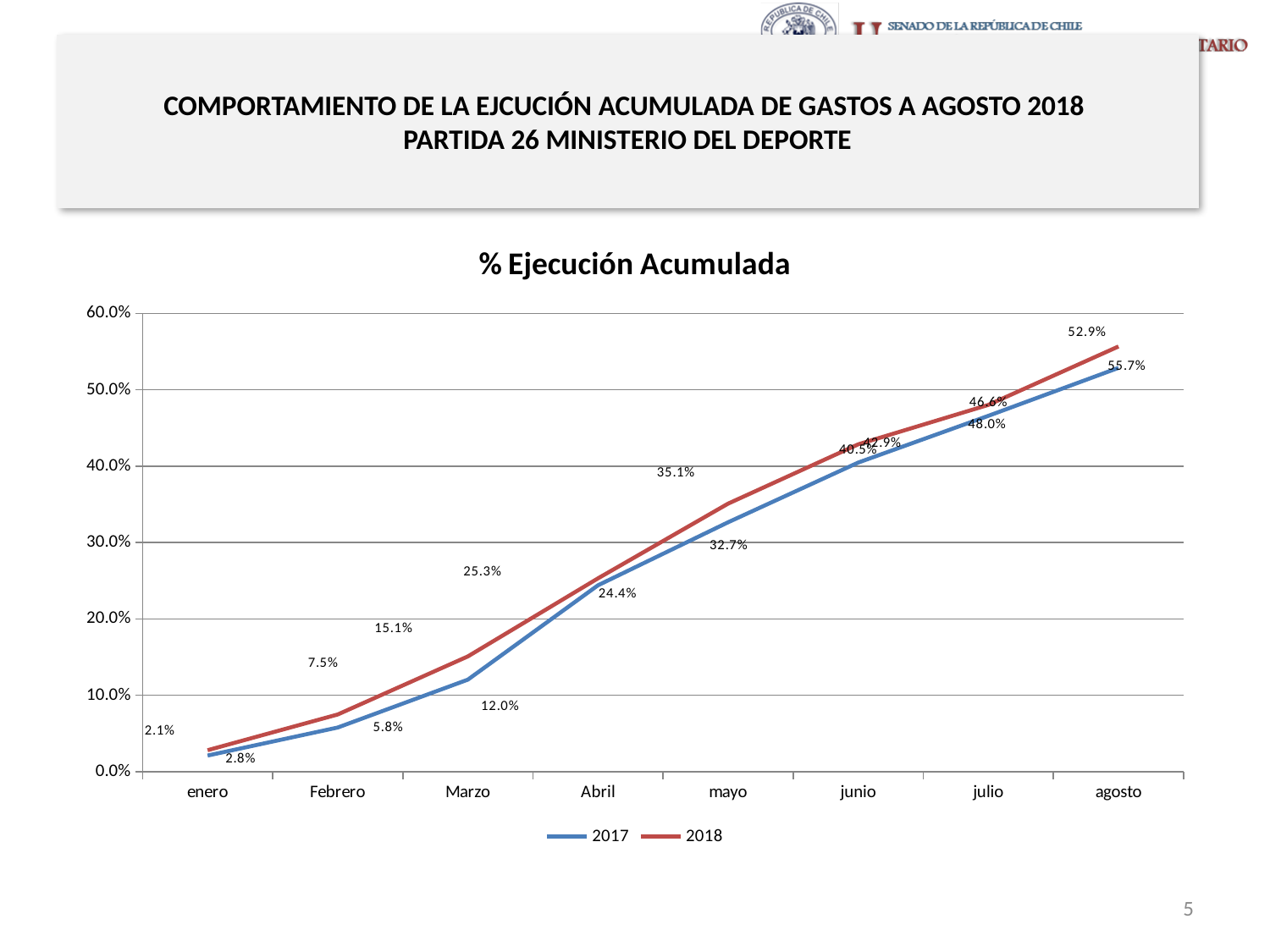
Is the value for 2017 in julio greater or less than 40.0%? greater What is the value for 2017 in Marzo? 12.0% What is the difference between the 2018 and 2017 values in mayo? 2.4% How many months are shown on the x axis of the chart? 8 What is the title of the chart? % Ejecución Acumulada How many series does the legend of the chart list? 2 In junio, which series has the higher value, 2017 or 2018? 2018 What is the value for 2018 in mayo? 35.1% Do the values of the 2018 line rise or fall from enero to agosto? rise What is the value for 2017 in junio? 40.5% What type of chart is shown on the slide? line chart What is the value for 2018 in Abril? 25.3%